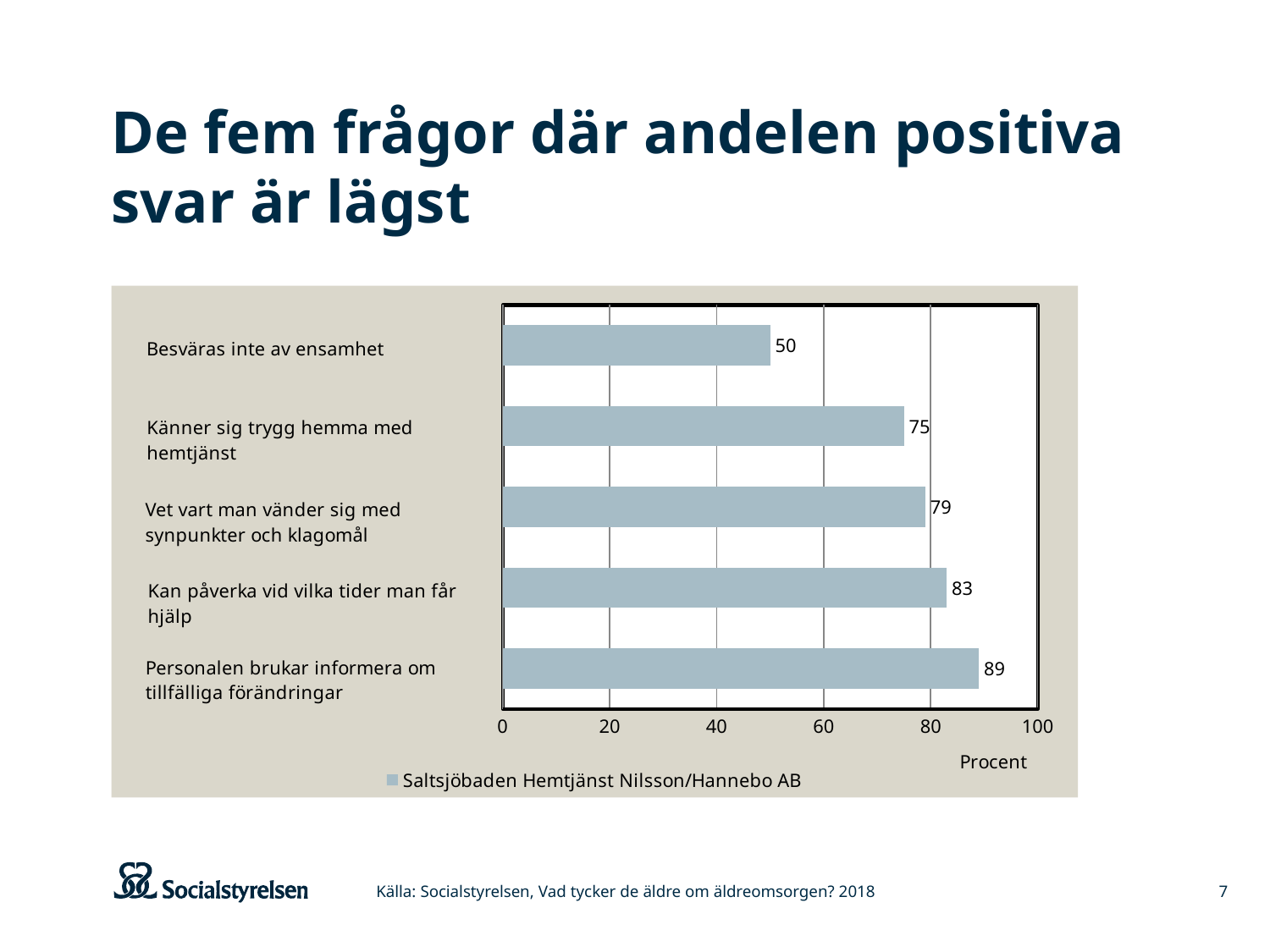
What is the value for "Besväras inte av ensamhet"? 50 Which category has the highest value? Personalen brukar informera om tillfälliga förändringar What kind of chart is shown on the slide? bar chart How many series does the legend list? 1 Which category has the lowest value? Besväras inte av ensamhet What is the value for "Personalen brukar informera om tillfälliga förändringar"? 89 What is the difference between the values for "Kan påverka vid vilka tider man får hjälp" and "Vet vart man vänder sig med synpunkter och klagomål"? 4 Is the value for "Vet vart man vänder sig med synpunkter och klagomål" greater or less than 60? greater What is the value for "Känner sig trygg hemma med hemtjänst"? 75 How many categories are shown in the chart? 5 Which is larger: the value for "Känner sig trygg hemma med hemtjänst" or the value for "Kan påverka vid vilka tider man får hjälp"? Kan påverka vid vilka tider man får hjälp What is the series name shown in the legend? Saltsjöbaden Hemtjänst Nilsson/Hannebo AB